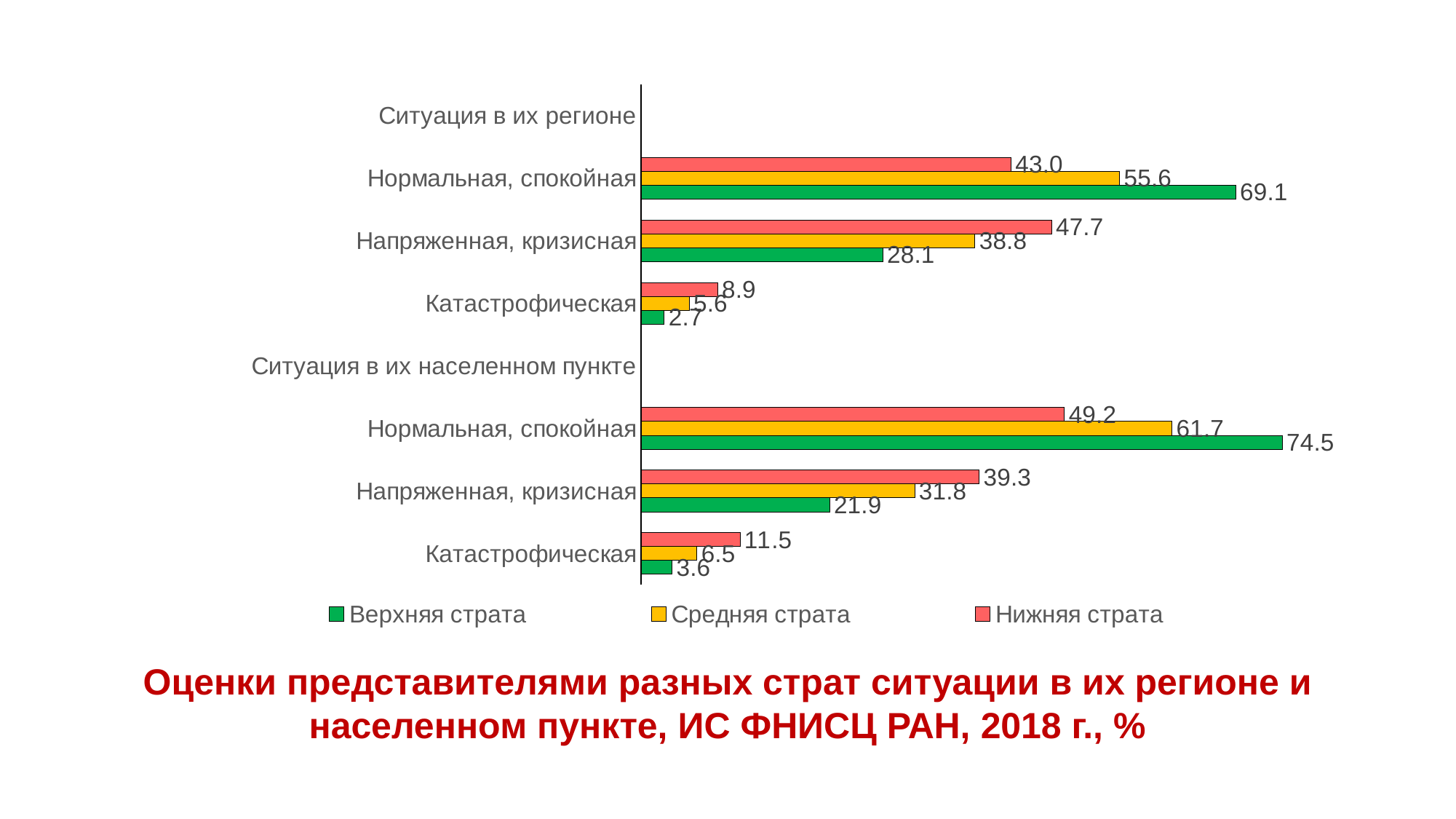
What kind of chart is shown on the slide? Bar chart What is the value for Нижняя страта for 'Напряженная, кризисная' under 'Ситуация в их населенном пункте'? 39.3 What is the difference between the Нижняя страта and Верхняя страта values for 'Напряженная, кризисная' under 'Ситуация в их регионе'? 19.6 How many series does the legend list? 3 Which series has the lowest value for 'Катастрофическая' under 'Ситуация в их населенном пункте'? Верхняя страта What is the value for Нижняя страта for 'Катастрофическая' under 'Ситуация в их населенном пункте'? 11.5 Which series has the highest value for 'Нормальная, спокойная' under 'Ситуация в их населенном пункте'? Верхняя страта What is the value for Средняя страта for 'Катастрофическая' under 'Ситуация в их регионе'? 5.6 Which is larger: the Средняя страта value for 'Нормальная, спокойная' under 'Ситуация в их регионе' or under 'Ситуация в их населенном пункте'? Ситуация в их населенном пункте Which colour represents Нижняя страта in the chart? Red What is the difference between the Верхняя страта values for 'Нормальная, спокойная' in the two groups (населенный пункт minus регион)? 5.4 What is the value for Верхняя страта for 'Нормальная, спокойная' under 'Ситуация в их регионе'? 69.1